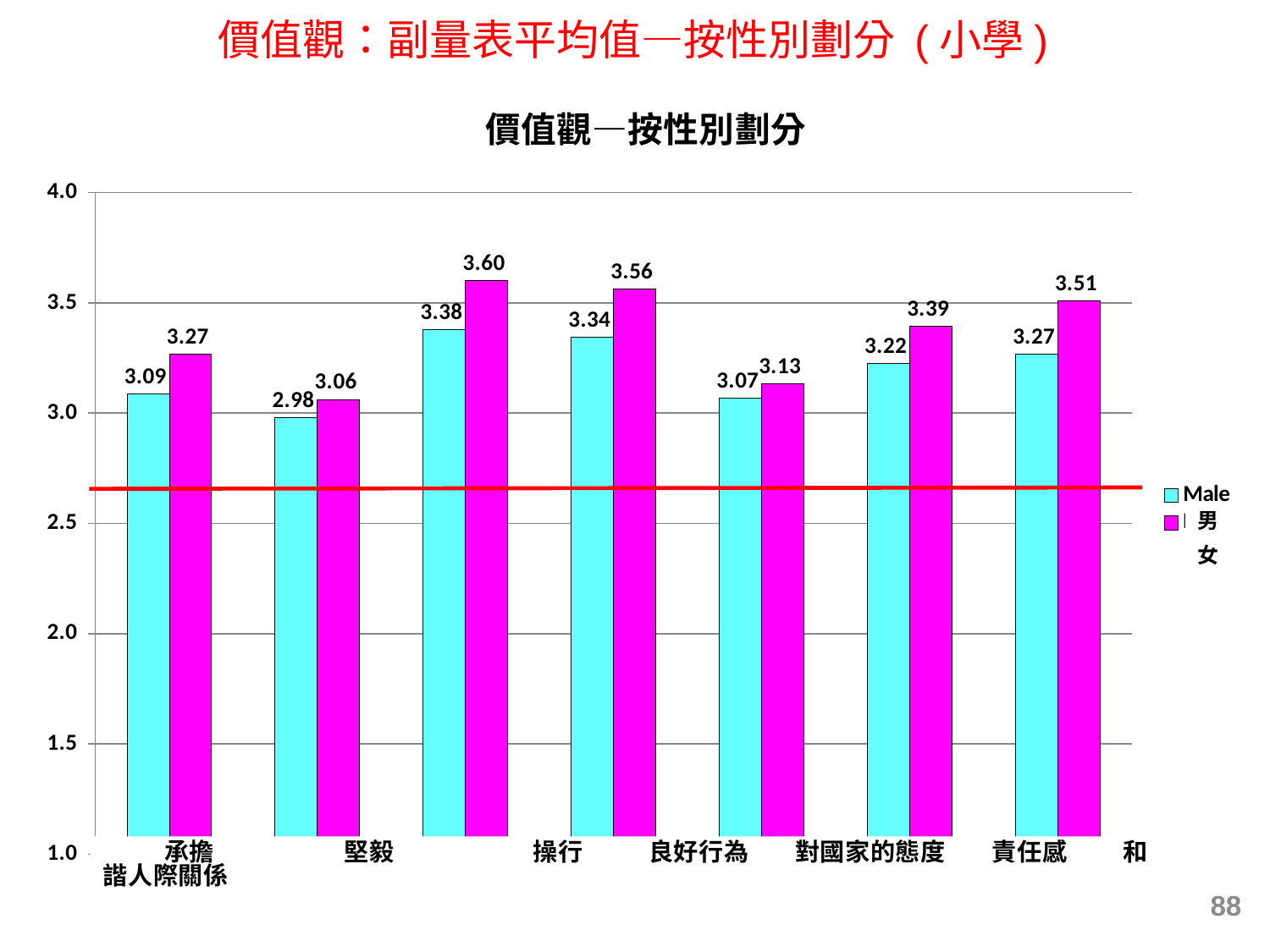
What is the difference between the magenta and cyan bars for 承擔? 0.18 What is the title printed above the chart? 價值觀─按性別劃分 What is the value of the magenta bar for 承擔? 3.27 Which is larger for 堅毅, the cyan (Male) bar or the magenta bar? the magenta bar What is the highest value labelled on any bar in the chart? 3.60 Is the cyan (Male) bar for 堅毅 greater or less than 3.0? less How many category groups of bars are plotted in the chart? 7 What is the lowest value labelled on any bar in the chart? 2.98 What is the value of the cyan (Male) bar for 承擔? 3.09 What is the value of the cyan (Male) bar for 堅毅? 2.98 What kind of chart is shown on the slide? bar chart What is the value of the magenta bar for 堅毅? 3.06